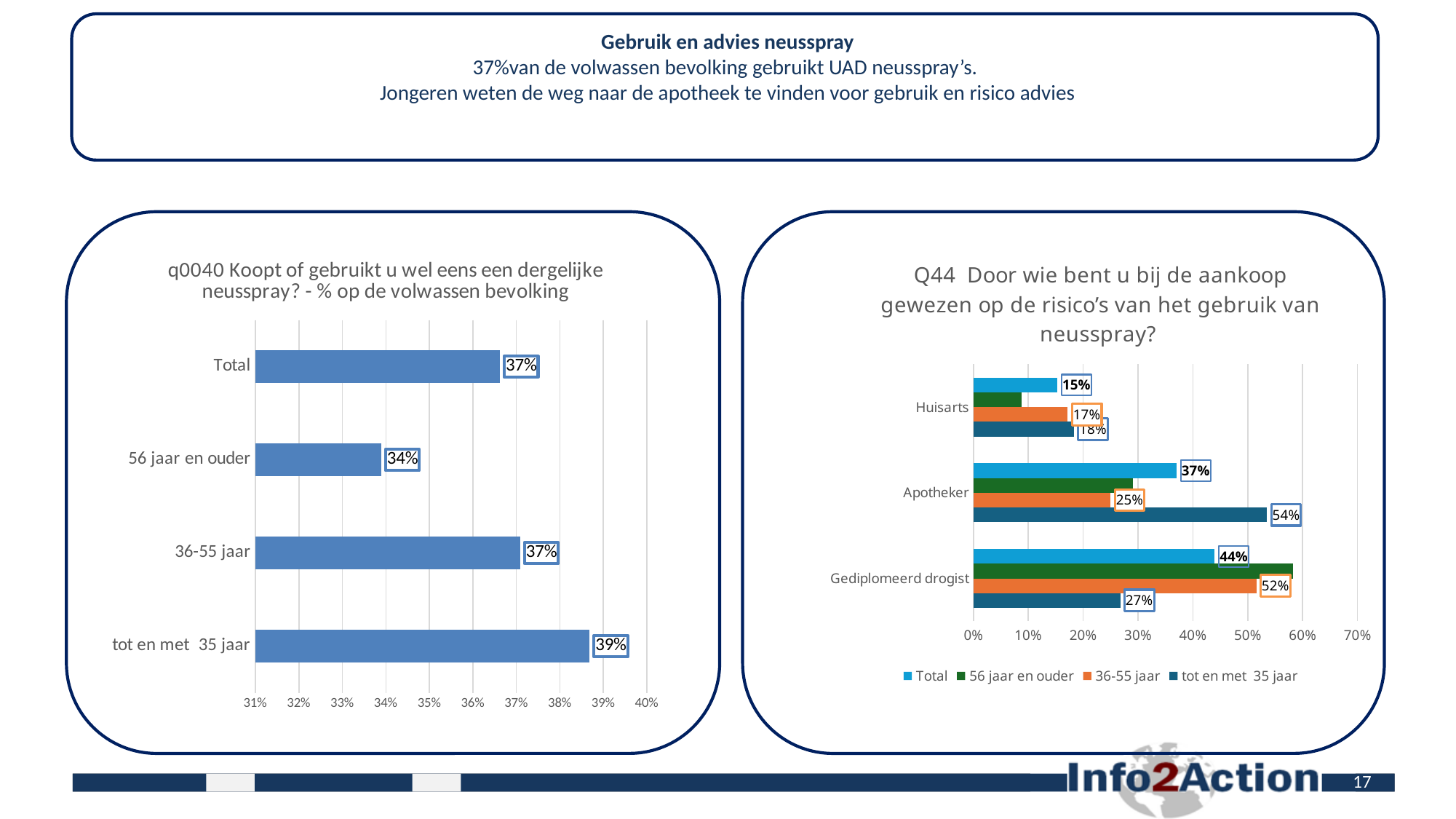
In the right chart (Q44), what is the Total value for 'Gediplomeerd drogist'? 44% In the left chart (q0040), what is the difference between 'tot en met 35 jaar' and '56 jaar en ouder'? 5% In the right chart (Q44), what is the value for 'tot en met 35 jaar' at 'Apotheker'? 54% In the left chart (q0040), which category has the highest value? tot en met 35 jaar In the left chart (q0040), which category has the lowest value? 56 jaar en ouder In the left chart (q0040), how many categories are shown? 4 In the left chart (q0040), what is the value for '56 jaar en ouder'? 34% In the right chart (Q44), which is larger at 'Apotheker': the value for 'tot en met 35 jaar' or for '36-55 jaar'? tot en met 35 jaar In the right chart (Q44), is the value for '56 jaar en ouder' at 'Gediplomeerd drogist' greater or less than 50%? greater In the right chart (Q44), how many series does the legend list? 4 In the left chart (q0040), what is the value for 'tot en met 35 jaar'? 39% In the right chart (Q44), what is the value for '36-55 jaar' at 'Huisarts'? 17%